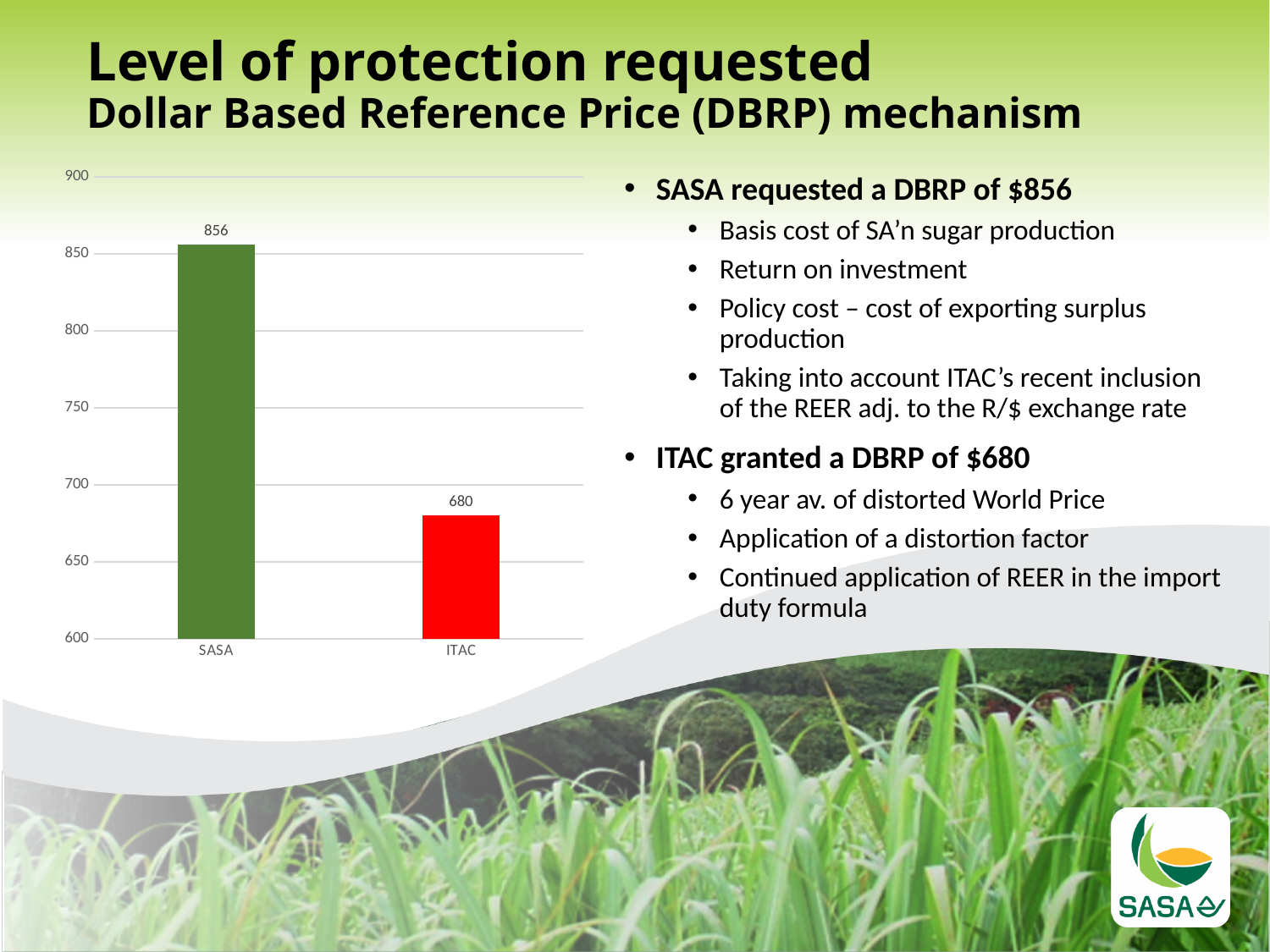
What is the value shown for SASA in the chart? 856 What is the lowest value shown on the chart's vertical axis? 600 Which category has the lowest value in the chart? ITAC Which category has the highest value in the chart? SASA Is the value for ITAC greater or less than 700? less What is the value shown for ITAC in the chart? 680 What kind of chart is shown on the slide? bar chart What colour is the bar for ITAC in the chart? red Is the value for SASA greater or less than 850? greater What is the difference between the SASA value and the ITAC value in the chart? 176 Which is larger in the chart, the value for SASA or the value for ITAC? SASA How many categories are shown on the x axis of the chart? 2